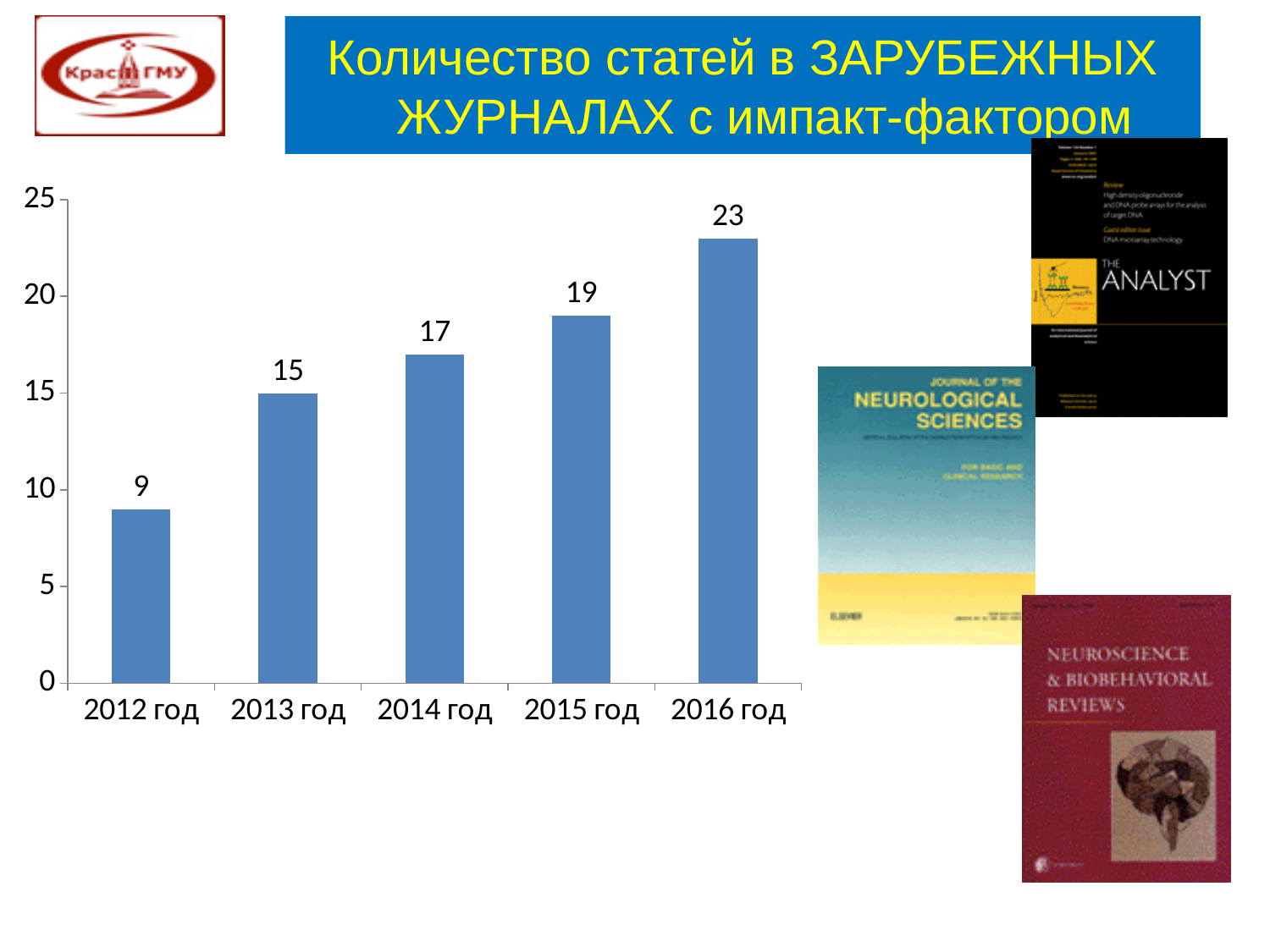
Do the values rise or fall from 2012 год to 2016 год? rise Which year has the highest value? 2016 год Which year has the lowest value? 2012 год What is the value for 2014 год? 17 Which is larger, the value for 2013 год or the value for 2015 год? 2015 год What is the value for 2016 год? 23 How many years are shown on the x axis? 5 What is the value for 2012 год? 9 What kind of chart is shown on the slide? bar chart Is the value for 2014 год greater or less than 15? greater What is the difference between the values for 2015 год and 2013 год? 4 What is the difference between the values for 2016 год and 2012 год? 14